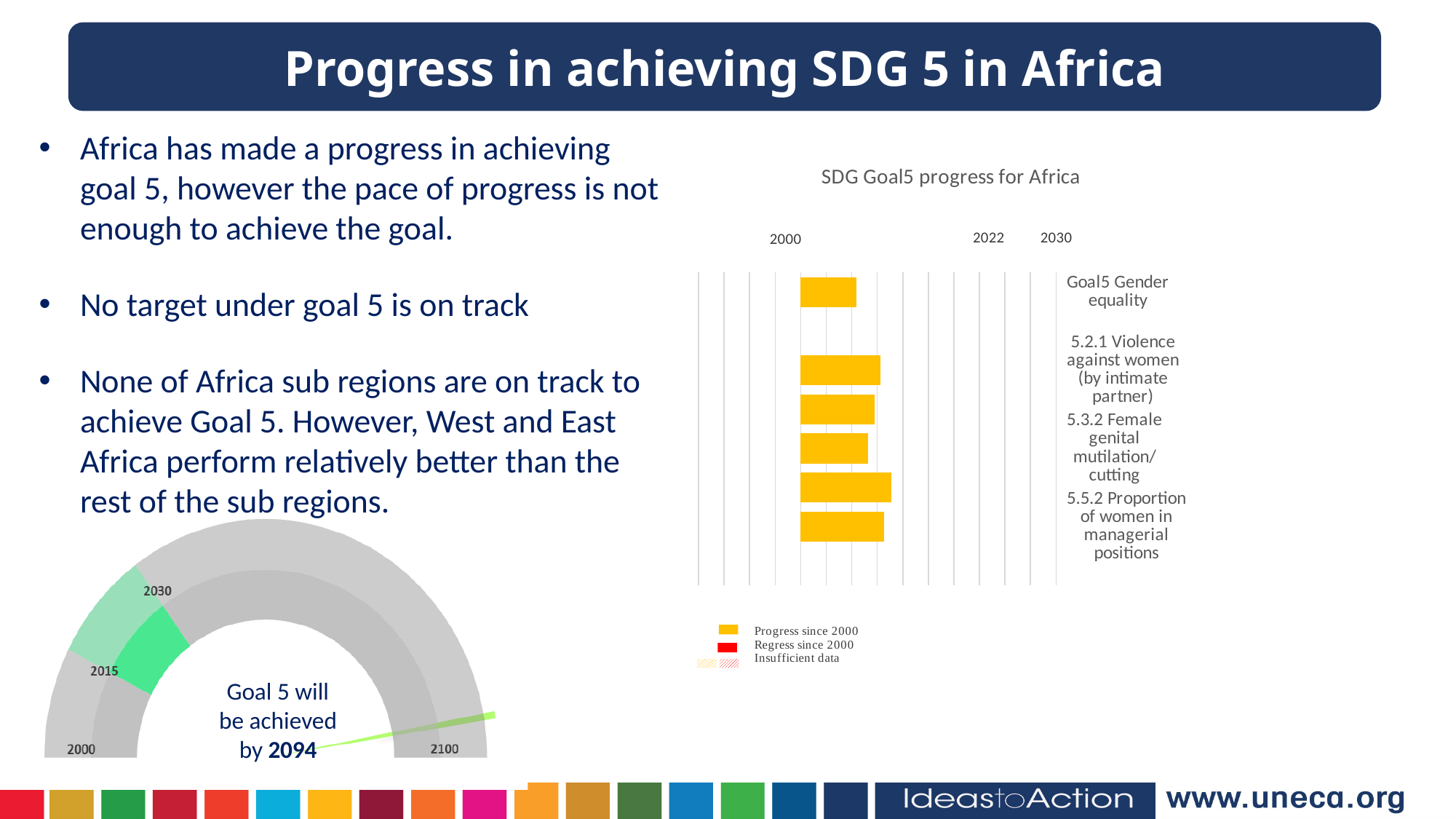
In the 'SDG Goal5 progress for Africa' chart, is the bar for Goal5 Gender equality greater or less than 2022? less According to the gauge chart at the bottom left, in what year will Goal 5 be achieved? 2094 On the gauge chart at the bottom left, what is the last year marked on the scale? 2100 In the 'SDG Goal5 progress for Africa' chart, do any of the bars reach the 2030 line? No On the gauge chart at the bottom left, is the projected achievement year for Goal 5 greater or less than 2030? greater In the 'SDG Goal5 progress for Africa' chart, which category has the shortest bar? Goal5 Gender equality What kind of chart is 'SDG Goal5 progress for Africa'? bar chart How many entries does the legend of the 'SDG Goal5 progress for Africa' chart list? 3 In the 'SDG Goal5 progress for Africa' chart, which legend entry do the yellow bars represent? Progress since 2000 How many bars are plotted in the 'SDG Goal5 progress for Africa' chart? 6 In the 'SDG Goal5 progress for Africa' chart, what year does the leftmost axis label show? 2000 What is the title of the bar chart on the right of the slide? SDG Goal5 progress for Africa